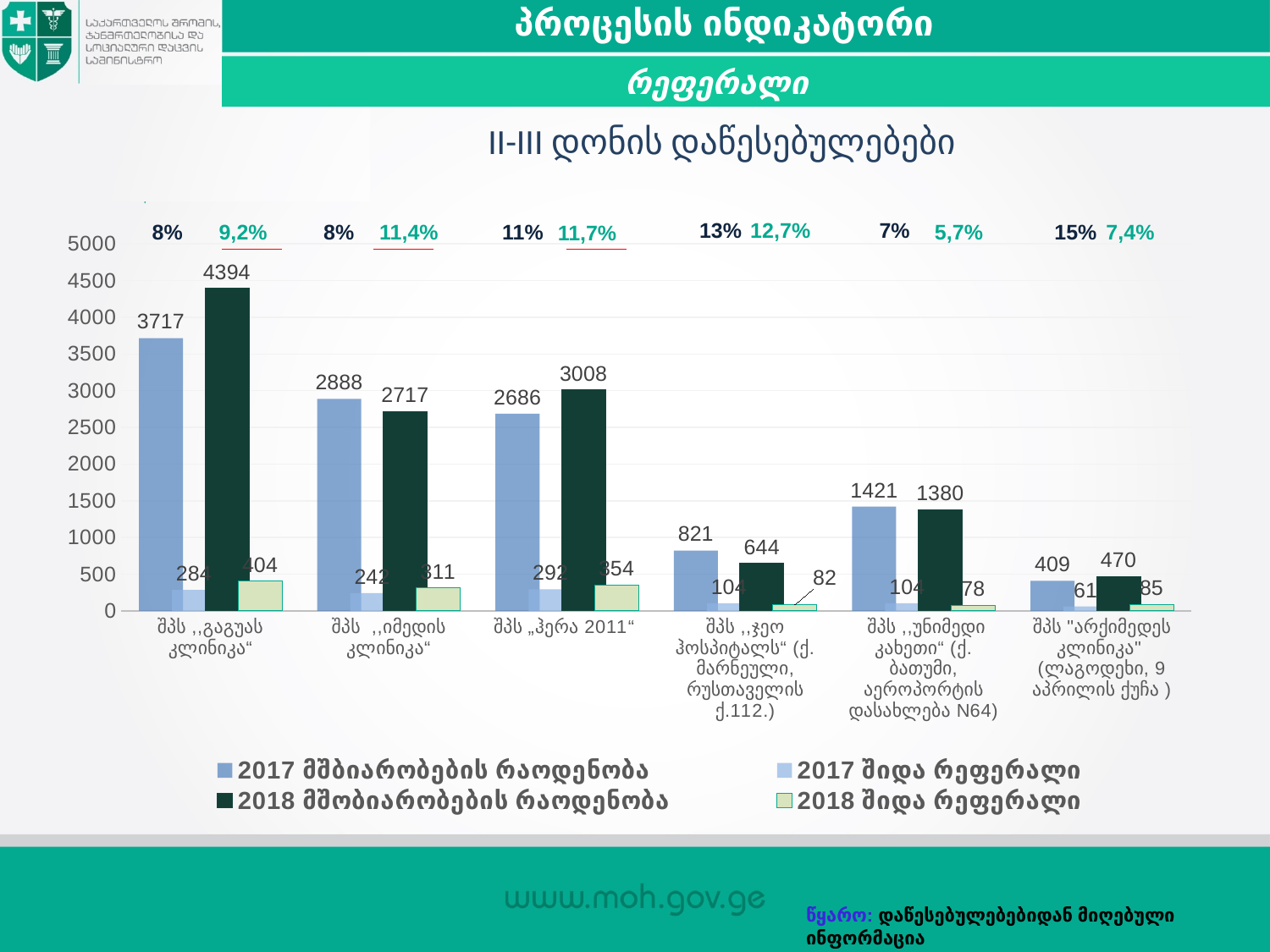
Which clinic has the highest 2017 მშბიარობების რაოდენობა value? შპს „გაგუას კლინიკა“ What is the 2018 შიდა რეფერალი value for შპს „იმედის კლინიკა“? 311 How many series does the legend list? 4 What is the title of the chart? II-III დონის დაწესებულებები Is the 2017 მშბიარობების რაოდენობა value for შპს „უნიმედი კახეთი“ greater or less than 1000? greater Which clinic has the lowest 2018 მშობიარობების რაოდენობა value? შპს „არქიმედეს კლინიკა“ What is the 2018 მშობიარობების რაოდენობა value for შპს „გაგუას კლინიკა“? 4394 How many clinics (categories) are shown on the x axis? 6 What is the difference between the 2018 and 2017 მშობიარობების რაოდენობა values for შპს „გაგუას კლინიკა“? 677 What type of chart is shown on the slide? bar chart For შპს „იმედის კლინიკა“, which is larger: the 2017 მშბიარობების რაოდენობა or the 2018 მშობიარობების რაოდენობა? 2017 მშბიარობების რაოდენობა